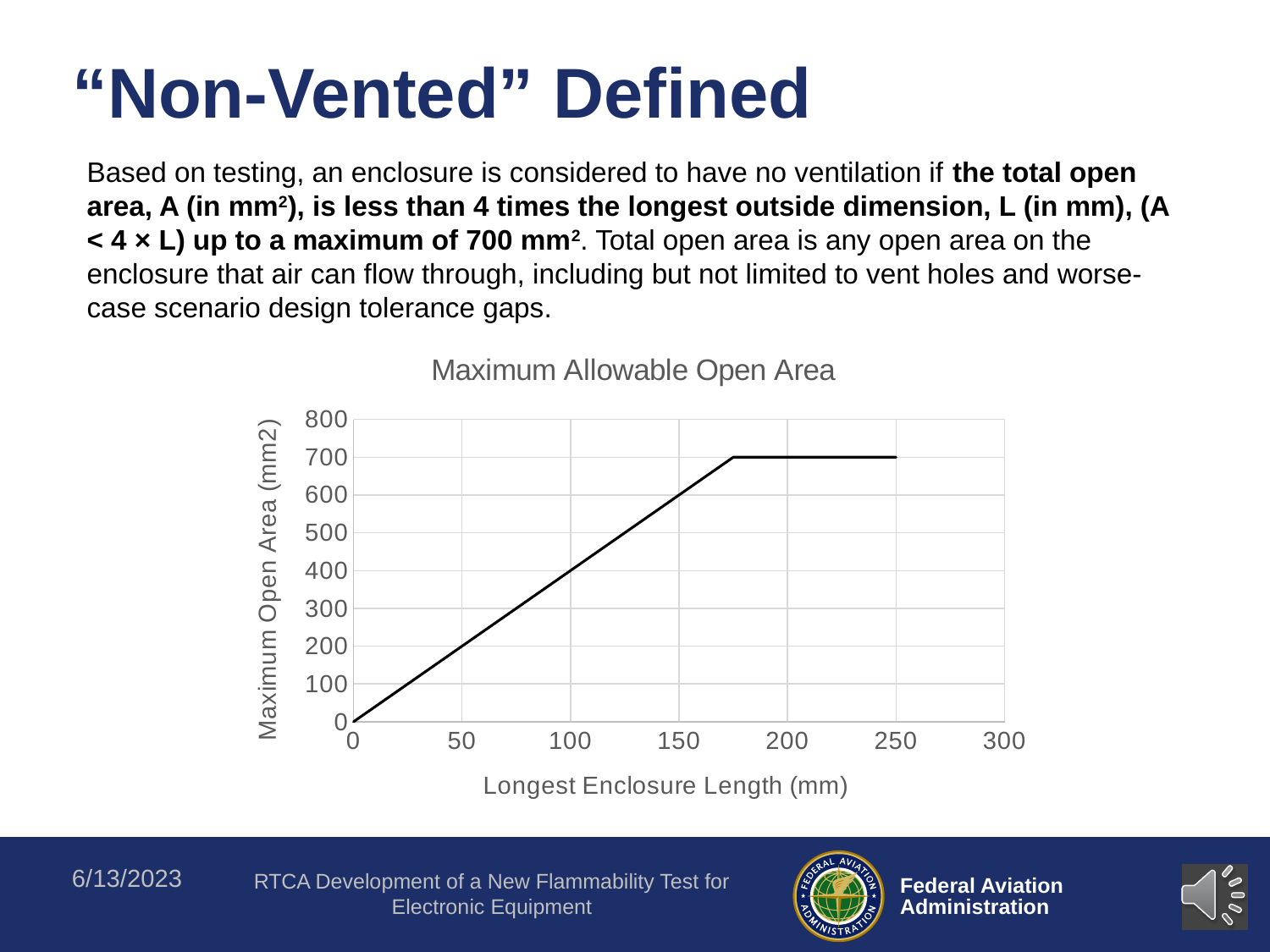
What is the maximum open area at a longest enclosure length of 150 mm? 600 What is the highest value the line reaches on the y axis? 700 Is the maximum open area at 200 mm greater or less than 600? greater What is the maximum open area at a longest enclosure length of 100 mm? 400 What is the label of the x axis of the chart? Longest Enclosure Length (mm) What is the maximum open area at a longest enclosure length of 50 mm? 200 How does the maximum open area change as the longest enclosure length increases from 0 to 250 mm? rises, then levels off What is the maximum open area at a longest enclosure length of 250 mm? 700 Which is larger, the maximum open area at 100 mm or at 200 mm? 200 mm What kind of chart is shown on the slide? line chart What is the title of the chart? Maximum Allowable Open Area What is the difference between the maximum open area at 150 mm and at 100 mm? 200